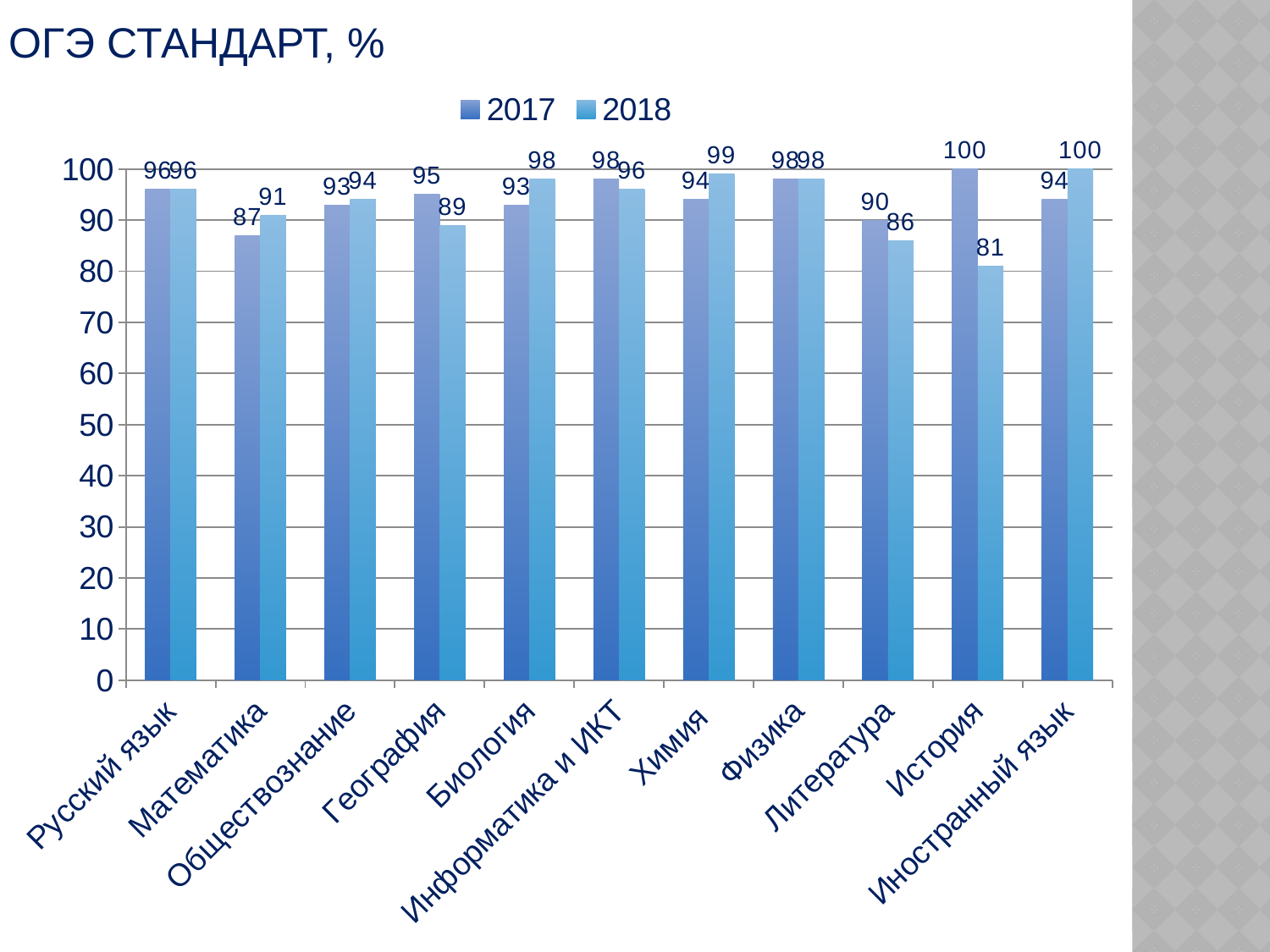
Which category has the lowest value in the 2017 series? Математика What is the difference between the 2017 and 2018 values for История? 19 Which is larger for География: the 2017 value or the 2018 value? 2017 Which category has the lowest value in the 2018 series? История What is the difference between the 2018 and 2017 values for Биология? 5 What is the title of the chart? ОГЭ СТАНДАРТ, % What kind of chart is shown on the slide? bar chart What is the value for История in the 2017 series? 100 What is the value for Литература in the 2018 series? 86 What is the value for Математика in the 2018 series? 91 How many series does the legend list? 2 How many categories are shown on the x axis? 11